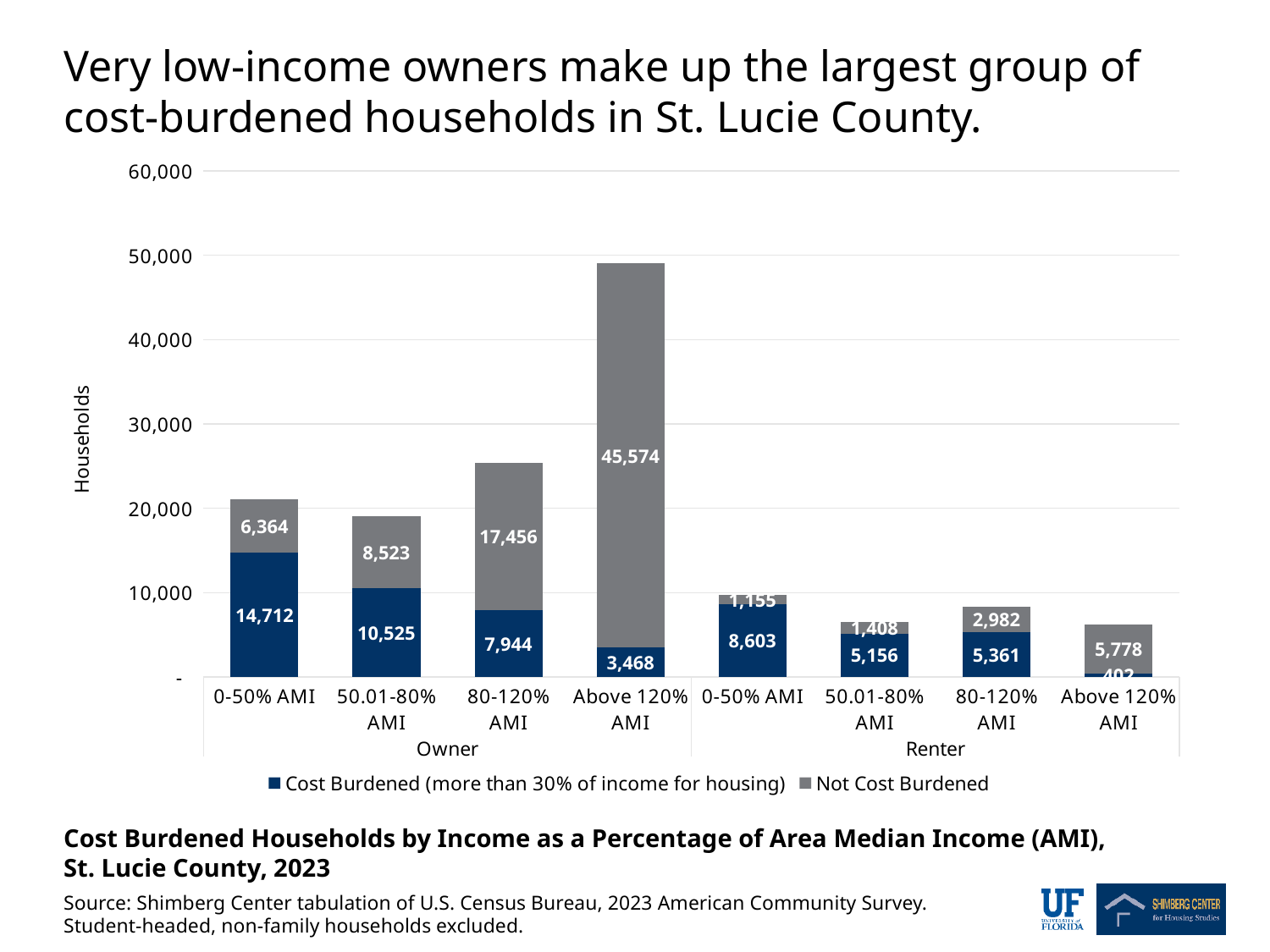
How many not-cost-burdened owner households are in the Above 120% AMI category? 45,574 Is the total height of the Owner Above 120% AMI bar greater or less than 40,000? greater How many income categories (bars) are plotted across the Owner and Renter groups? 8 How many cost-burdened renter households are in the 0-50% AMI category? 8,603 Which is larger: the number of cost-burdened owner households at 50.01-80% AMI or the number of cost-burdened renter households at 50.01-80% AMI? Owner (10,525) What kind of chart is shown on the slide? Stacked bar chart How many series does the legend list? 2 How many cost-burdened owner households are in the 0-50% AMI category? 14,712 What is the difference between cost-burdened owner households and cost-burdened renter households in the 0-50% AMI category? 6,109 What is the total number of households (cost burdened plus not cost burdened) for owners in the 80-120% AMI category? 25,400 Which category has the largest number of not-cost-burdened households? Owner, Above 120% AMI Which category has the largest number of cost-burdened households? Owner, 0-50% AMI